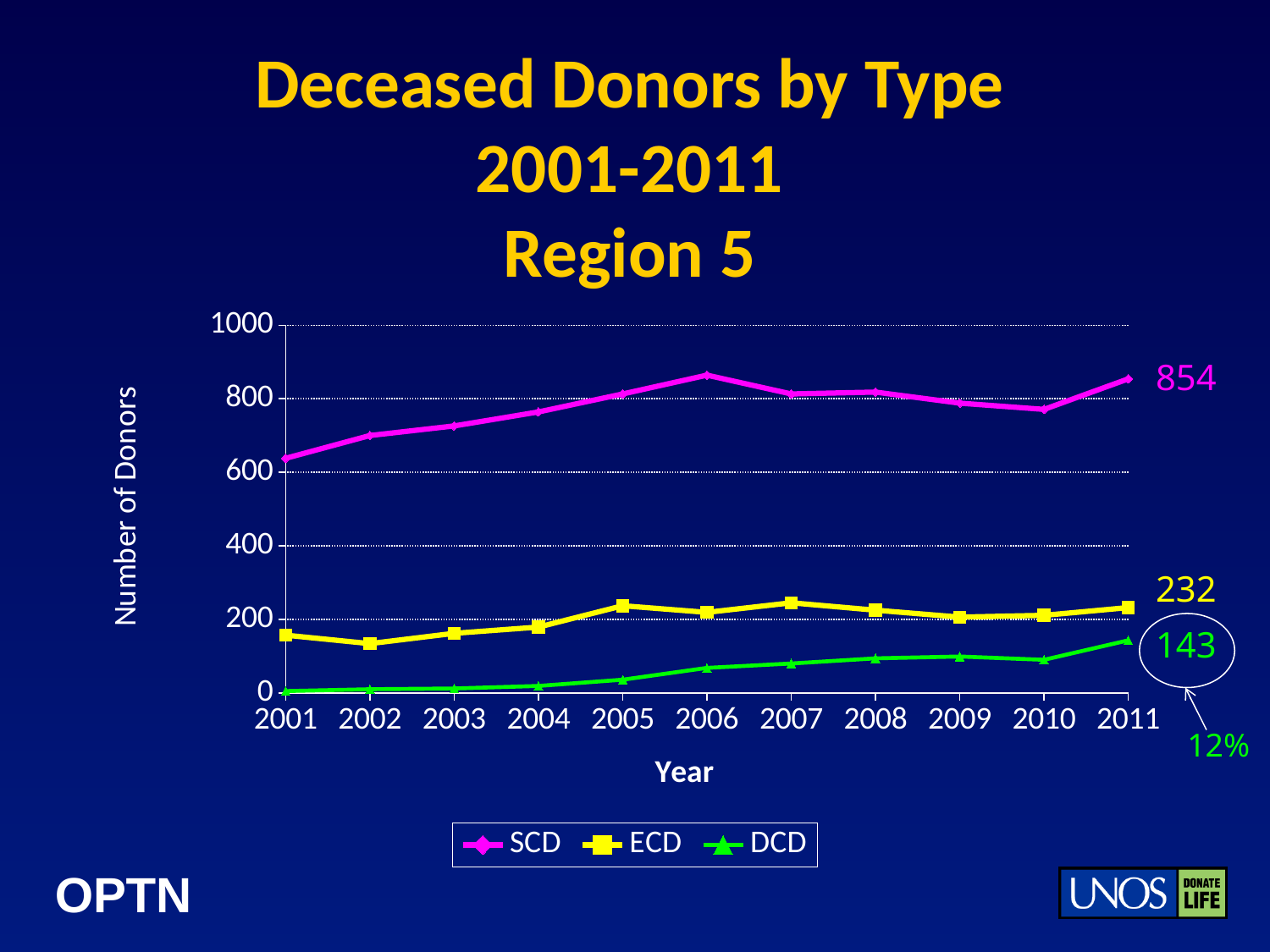
What is the value for DCD in 2011? 143 Which series has the highest value in 2011? SCD What is the value for ECD in 2011? 232 What is the difference between the SCD and ECD values in 2011? 622 How many series does the legend list? 3 Is the value for SCD in 2006 greater or less than 800? greater What is the value for SCD in 2011? 854 Is the value for SCD in 2001 greater or less than 800? less Which series has the lowest value in 2011? DCD What is the difference between the ECD and DCD values in 2011? 89 How many years are shown on the x axis? 11 What kind of chart is shown on the slide? line chart